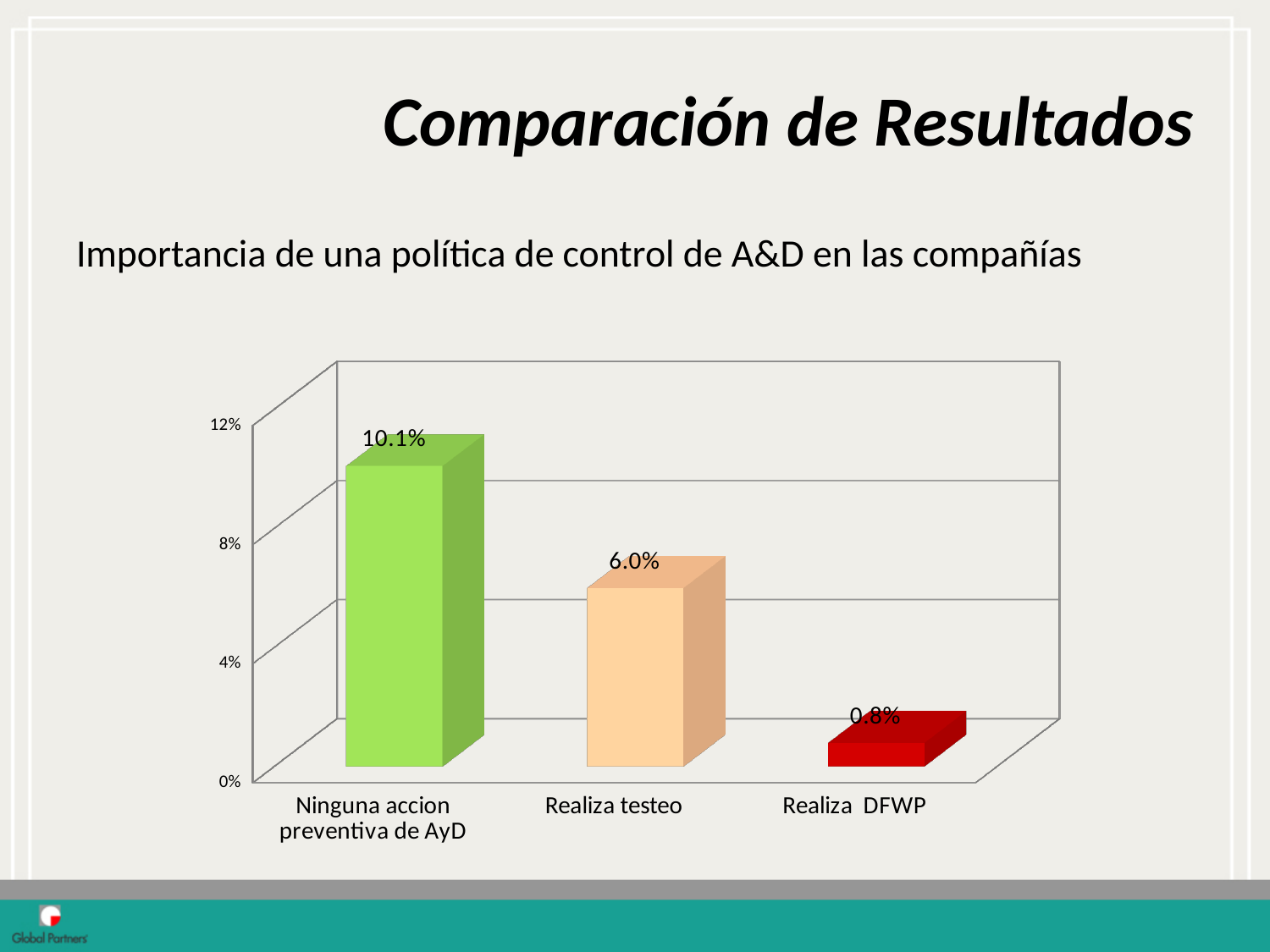
How many categories are shown in the chart? 3 What is the value for 'Realiza testeo'? 6.0% Which category has the highest value? Ninguna accion preventiva de AyD Do the values rise or fall from left to right across the categories? fall What is the value for 'Ninguna accion preventiva de AyD'? 10.1% Which category has the lowest value? Realiza DFWP What kind of chart is shown on the slide? bar chart What is the value for 'Realiza DFWP'? 0.8% Is the value for 'Ninguna accion preventiva de AyD' greater or less than 8%? greater Which is larger, the value for 'Realiza testeo' or the value for 'Realiza DFWP'? Realiza testeo What is the difference between the values for 'Realiza testeo' and 'Realiza DFWP'? 5.2% What is the difference between the values for 'Ninguna accion preventiva de AyD' and 'Realiza testeo'? 4.1%